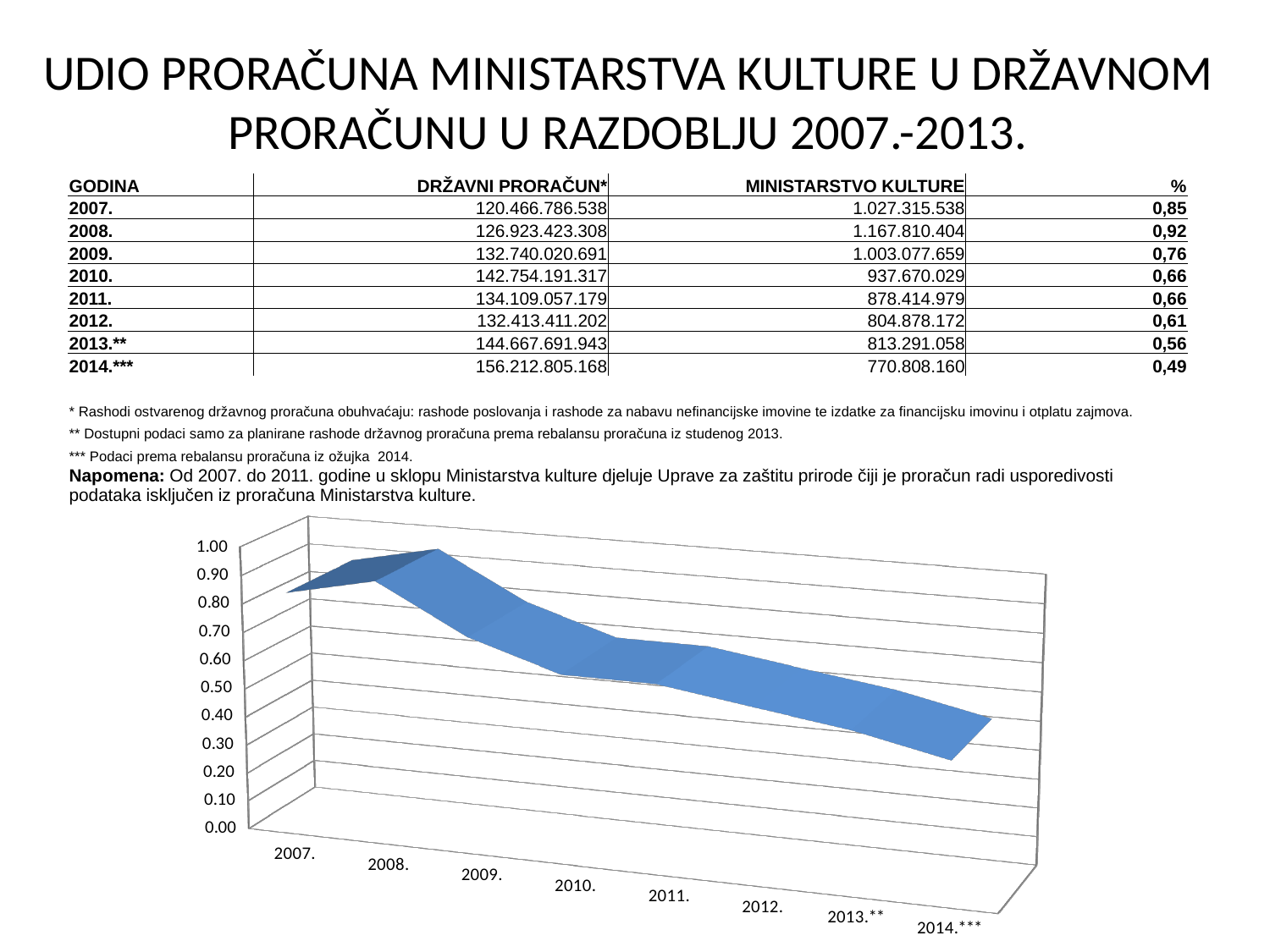
Which year has the lowest share (%) in the chart? 2014.*** Which year has the highest share (%) in the chart? 2008. What kind of chart is shown on the slide? 3D line chart What is the % value for 2008. shown in the table? 0,92 What is the % value for 2014.*** shown in the table? 0,49 Is the value for 2007. in the chart greater or less than 0.80? greater Which is larger, the % value for 2007. or the % value for 2009.? 2007. What is the highest tick value shown on the vertical axis of the chart? 1.00 Is the value for 2012. in the chart greater or less than 0.70? less Do the values in the chart generally rise or fall from 2007. to 2014.***? fall How many years are plotted along the x axis of the chart? 8 What is the difference between the % value for 2008. and the % value for 2014.***? 0,43